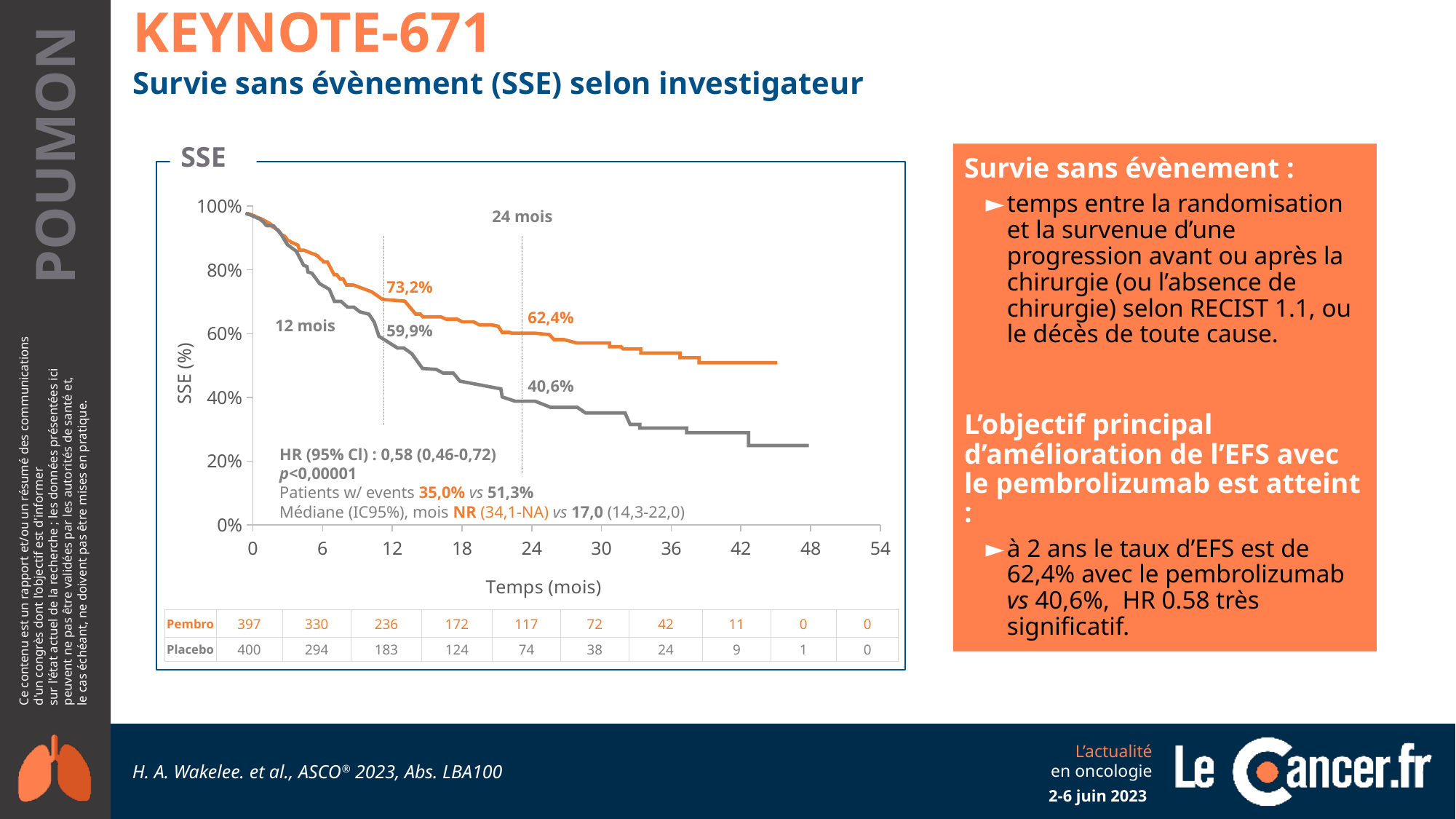
Is the placebo (grey) curve at 36 months greater or less than 40%? less What is the hazard ratio (95% CI) shown on the chart? 0,58 (0,46-0,72) Is the pembrolizumab (orange) curve at 36 months greater or less than 40%? greater What is the SSE rate for the pembrolizumab (orange) curve at 24 months? 62,4% What is the difference between the pembrolizumab and placebo SSE rates at 12 months? 13,3% What is the difference between the pembrolizumab and placebo SSE rates at 24 months? 21,8% How many patients in the Placebo group were at risk at 0 months? 400 How many patients in the Pembro group were at risk at 18 months according to the table below the chart? 172 At 12 months, which curve shows the higher SSE rate, pembrolizumab or placebo? Pembrolizumab Do the SSE curves rise or fall as time (months) increases? Fall What is the SSE rate for the pembrolizumab (orange) curve at 12 months? 73,2% What is the SSE rate for the placebo (grey) curve at 24 months? 40,6%